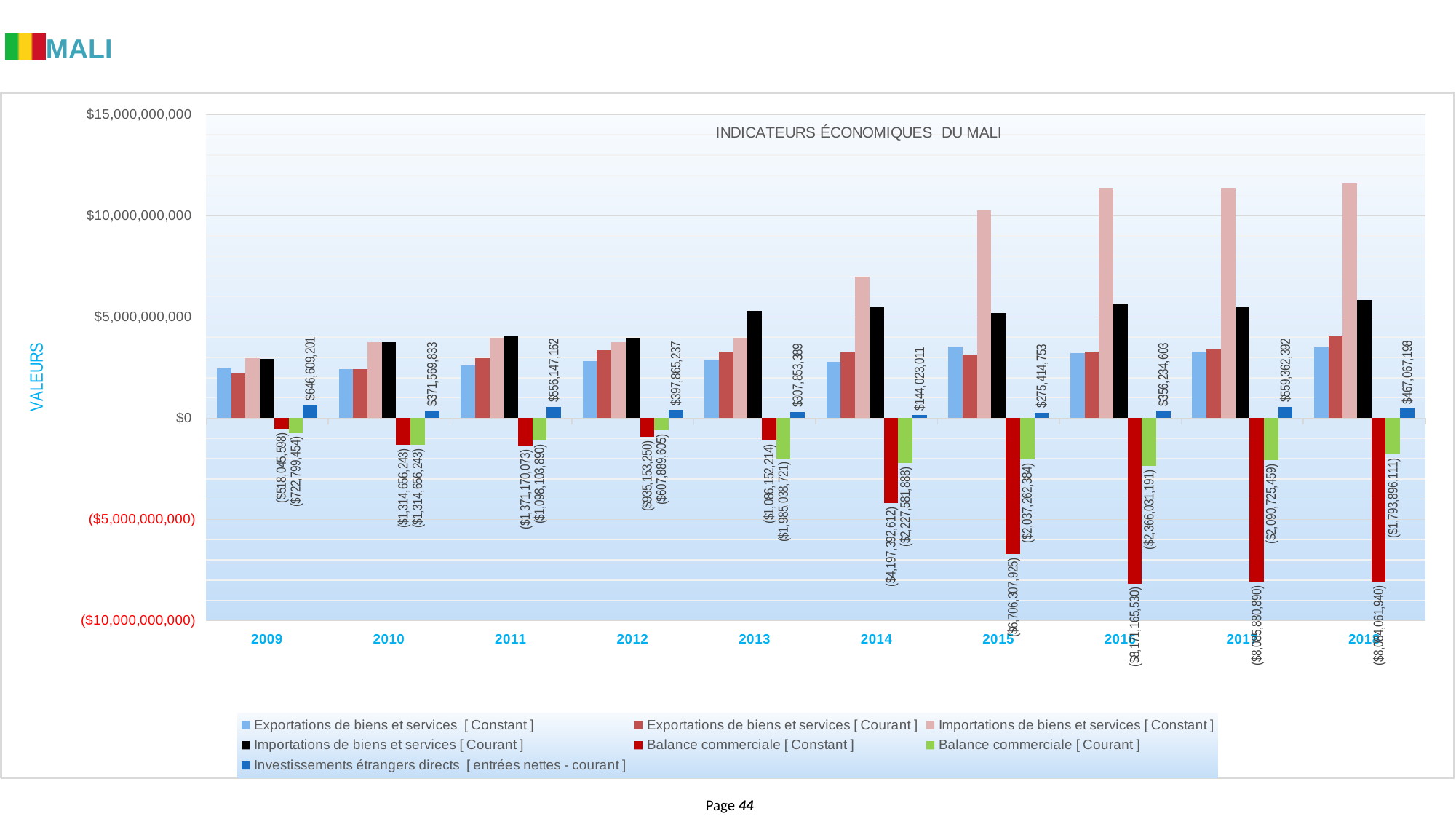
What is the value of Balance commerciale [Constant] for 2015? ($6,706,307,925) How many years are shown on the x axis of the chart? 10 Is the value of Importations de biens et services [Constant] for 2018 greater or less than $10,000,000,000? greater How many series does the legend list? 7 In which year is Investissements étrangers directs [entrées nettes - courant] the lowest? 2014 Which year has the larger value of Investissements étrangers directs, 2011 or 2012? 2011 What kind of chart is shown on the slide? bar chart What is the difference between Investissements étrangers directs in 2009 and in 2010? $275,039,368 What is the value of Balance commerciale [Courant] for 2014? ($2,227,581,888) What is the value of Investissements étrangers directs [entrées nettes - courant] for 2009? $646,609,201 What is the title of the chart? INDICATEURS ÉCONOMIQUES DU MALI In which year is Investissements étrangers directs [entrées nettes - courant] the highest? 2009